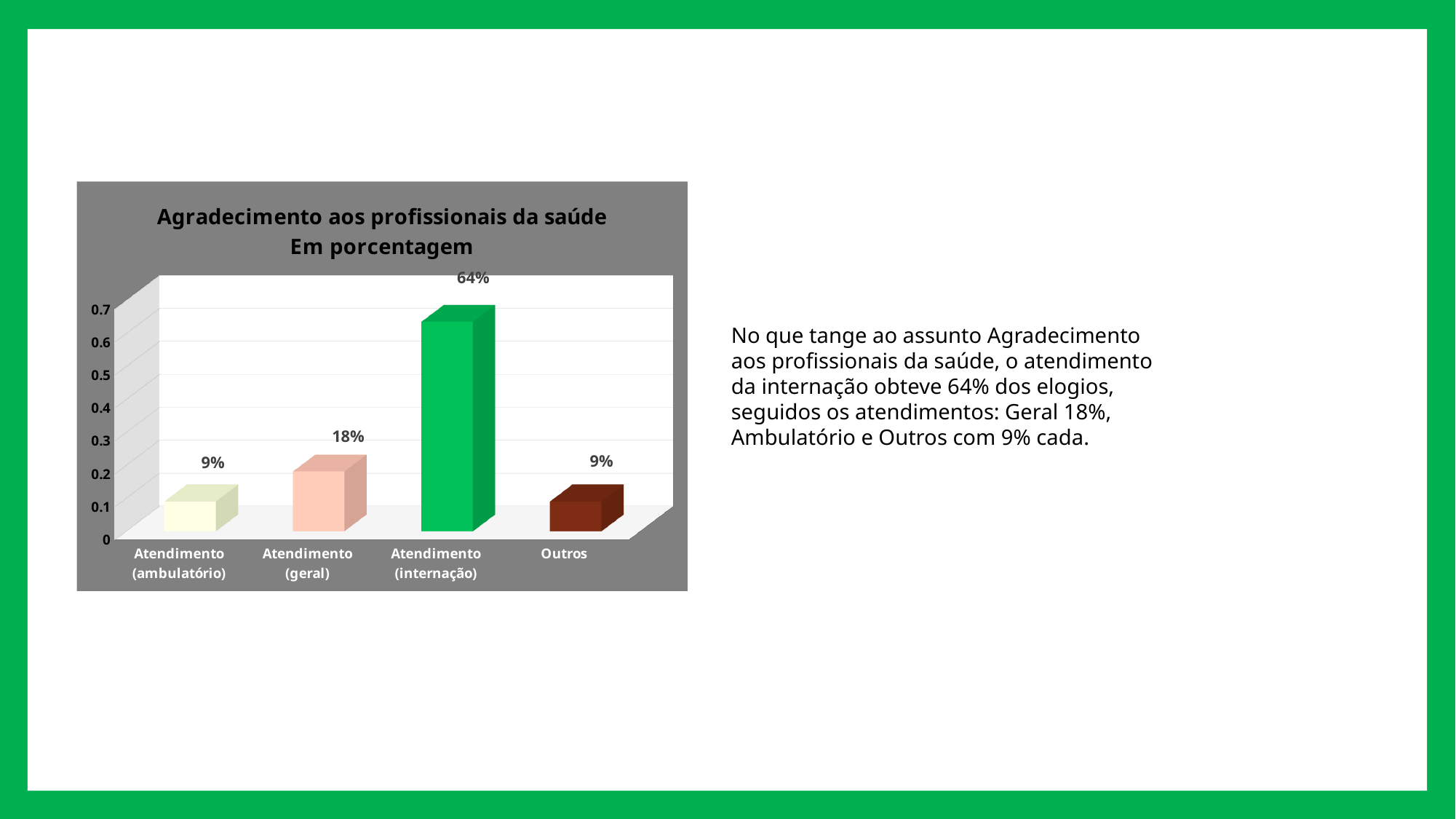
What is the difference between the values for Atendimento (geral) and Outros? 9% What colour is the bar for Atendimento (internação)? Green What kind of chart is shown on the slide? Bar chart Which is larger, the value for Atendimento (geral) or the value for Outros? Atendimento (geral) How many categories are shown on the x axis? 4 What is the value for Atendimento (geral)? 18% What is the title of the chart? Agradecimento aos profissionais da saúde Em porcentagem What is the value for Atendimento (internação)? 64% What is the value for Outros? 9% What is the value for Atendimento (ambulatório)? 9% Which category has the highest value? Atendimento (internação) What is the difference between the values for Atendimento (internação) and Atendimento (geral)? 46%